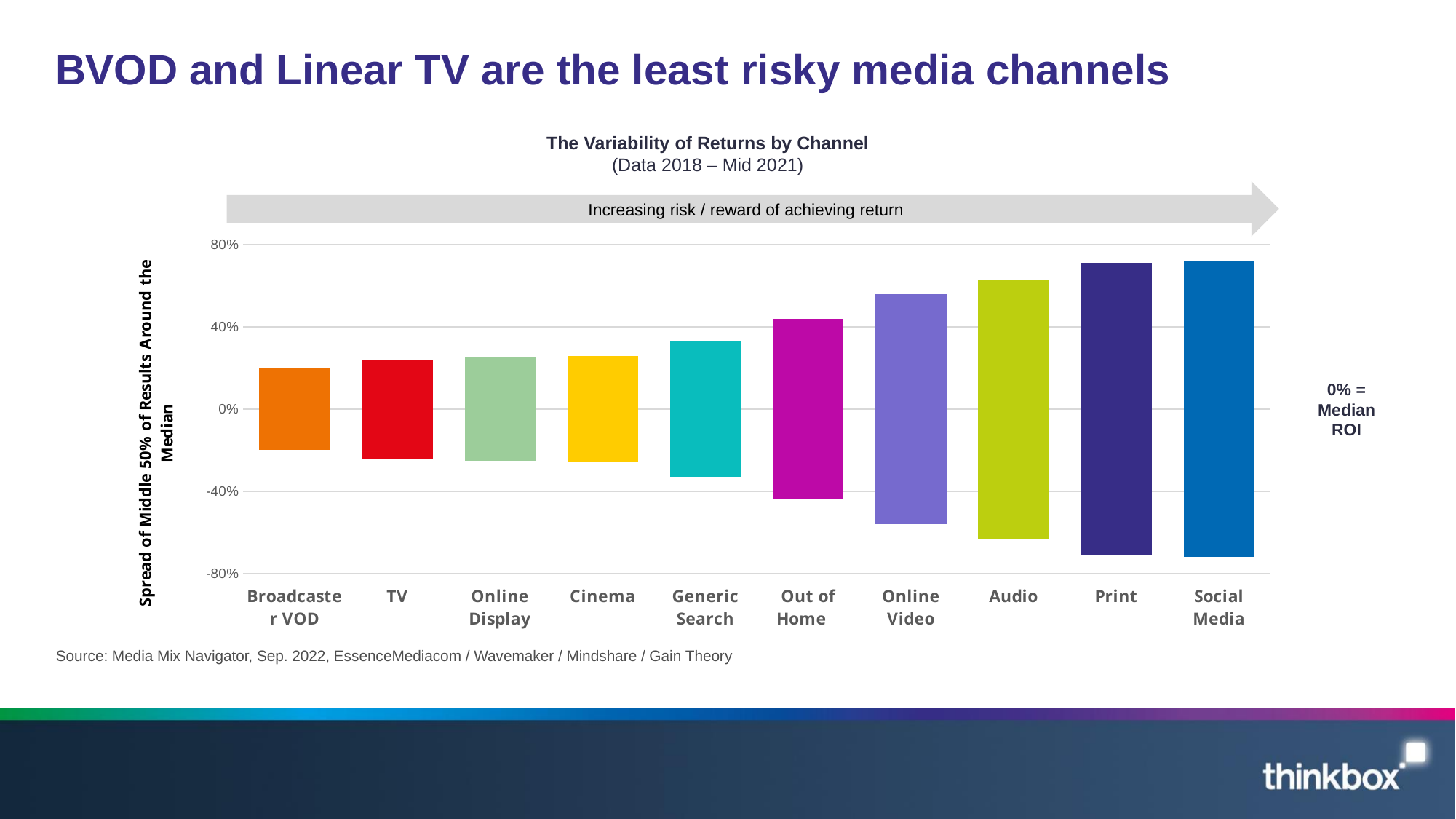
How many media channels are plotted on the chart? 10 Is the upper end of the Online Video bar greater or less than 40%? greater Is the upper end of the Broadcaster VOD bar greater or less than 40%? less Is the upper end of the Generic Search bar greater or less than 40%? less Which channel has the narrowest spread of results around the median? Broadcaster VOD What is the title of the chart? The Variability of Returns by Channel Does the spread of results increase or decrease moving from left to right across the channels? increase What kind of chart is shown on the slide? bar chart What does the label to the right of the chart say 0% represents? Median ROI Which channel has a wider spread of results, Cinema or Out of Home? Out of Home